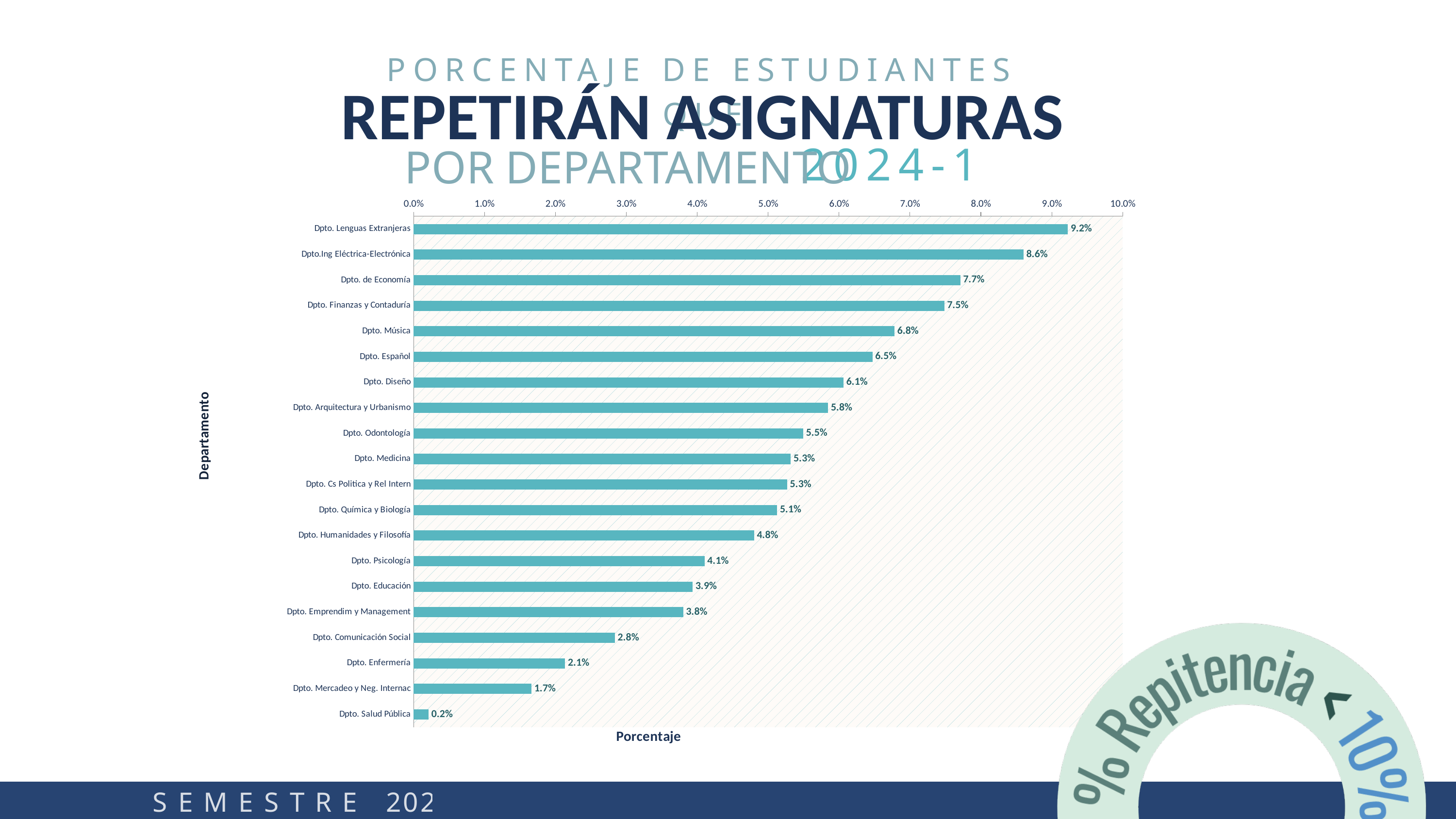
What is the value for Dpto. Lenguas Extranjeras? 9.2% Which department has the lowest percentage? Dpto. Salud Pública What is the label of the horizontal axis? Porcentaje Is the value for Dpto. Finanzas y Contaduría greater or less than 7.0%? greater What is the value for Dpto. Enfermería? 2.1% What is the difference between Dpto.Ing Eléctrica-Electrónica and Dpto. de Economía? 0.9% What is the value for Dpto. Música? 6.8% How many departments are shown in the chart? 20 Which department has the highest percentage? Dpto. Lenguas Extranjeras What kind of chart is shown on the slide? bar chart Which is larger, the value for Dpto. Diseño or the value for Dpto. Odontología? Dpto. Diseño What is the difference between Dpto. Psicología and Dpto. Comunicación Social? 1.3%